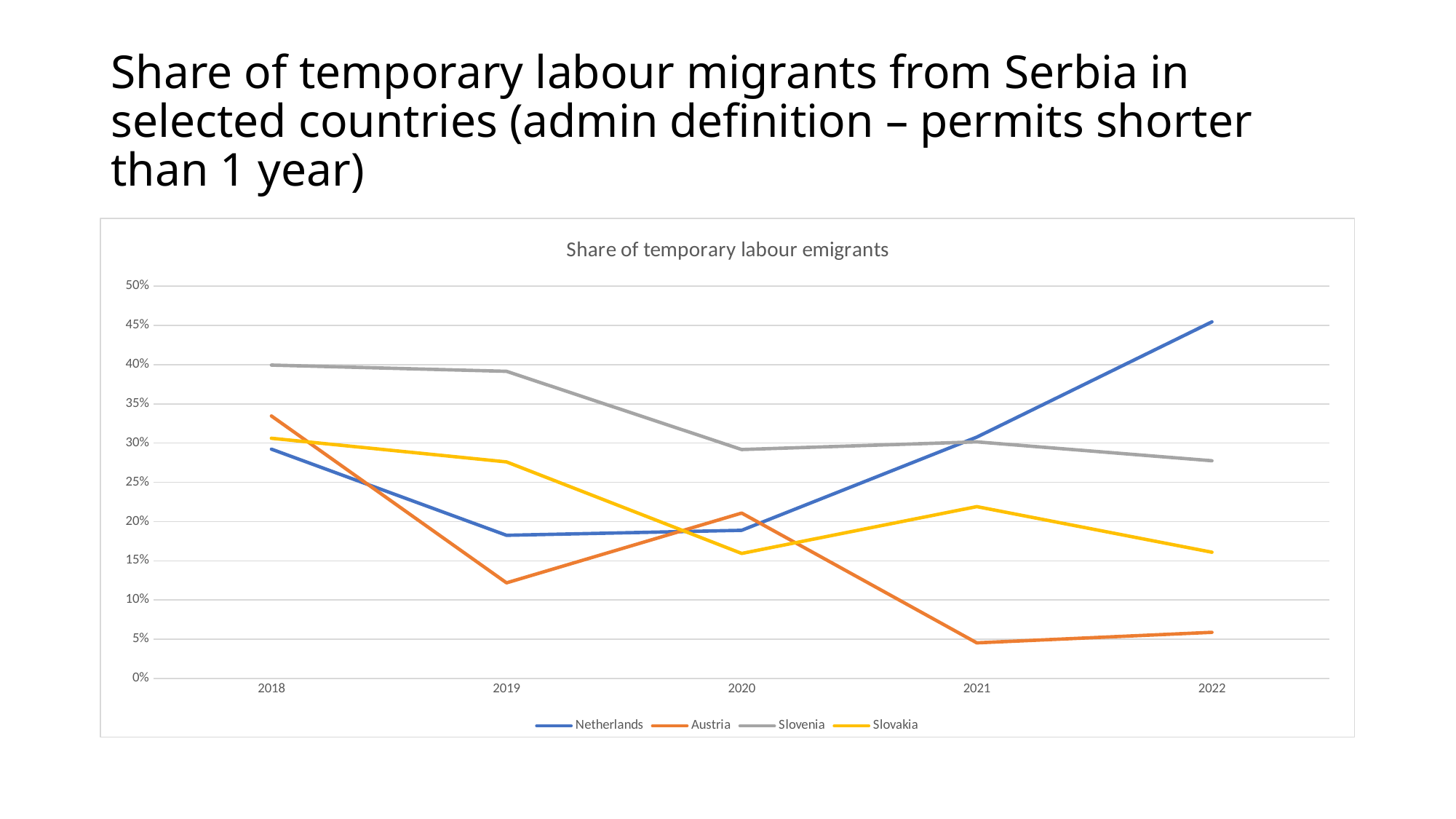
Is the value for Austria in 2021 greater or less than 10%? less Which is larger in 2020, the share for Slovenia or the share for Slovakia? Slovenia Does the share for Austria rise or fall from 2018 to 2021? fall How many series does the legend list? 4 Which country has the highest share in 2022? Netherlands What is the title printed inside the chart area? Share of temporary labour emigrants What kind of chart is shown on the slide? line chart Which country has the lowest share in 2021? Austria Is the value for Netherlands in 2022 greater or less than 40%? greater How many years are shown on the x axis? 5 Which country has the highest share in 2018? Slovenia Does the share for Netherlands rise or fall from 2020 to 2022? rise